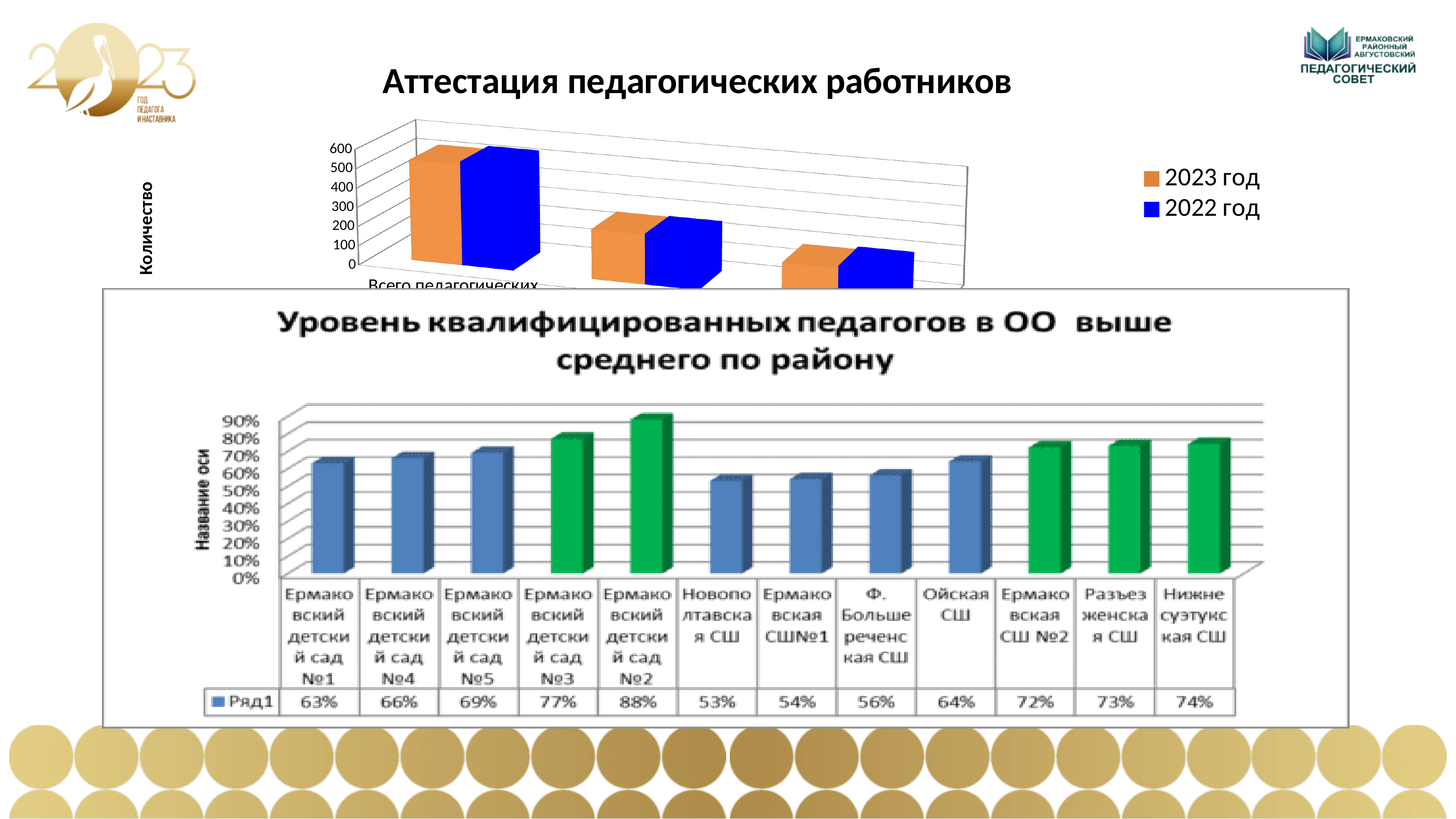
In the bottom chart 'Уровень квалифицированных педагогов в ОО выше среднего по району', which category has the lowest value? Новополтавская СШ How many series does the legend of the top chart list? 2 In the bottom chart 'Уровень квалифицированных педагогов в ОО выше среднего по району', what is the difference between the values for Нижнесуэтукская СШ and Ойская СШ? 10% In the bottom chart 'Уровень квалифицированных педагогов в ОО выше среднего по району', what is the value for Ермаковский детский сад №2? 88% In the bottom chart 'Уровень квалифицированных педагогов в ОО выше среднего по району', what is the value for Ф. Большереченская СШ? 56% In the top chart, which series is shown in orange? 2023 год In the bottom chart 'Уровень квалифицированных педагогов в ОО выше среднего по району', how many categories are shown? 12 In the bottom chart 'Уровень квалифицированных педагогов в ОО выше среднего по району', what is the value for Новополтавская СШ? 53% In the bottom chart 'Уровень квалифицированных педагогов в ОО выше среднего по району', which is larger: the value for Ермаковский детский сад №3 or for Ермаковская СШ №2? Ермаковский детский сад №3 In the bottom chart 'Уровень квалифицированных педагогов в ОО выше среднего по району', which category has the highest value? Ермаковский детский сад №2 What kind of chart is the bottom chart 'Уровень квалифицированных педагогов в ОО выше среднего по району'? Bar chart In the bottom chart 'Уровень квалифицированных педагогов в ОО выше среднего по району', what is the name of the series shown in the data table? Ряд1